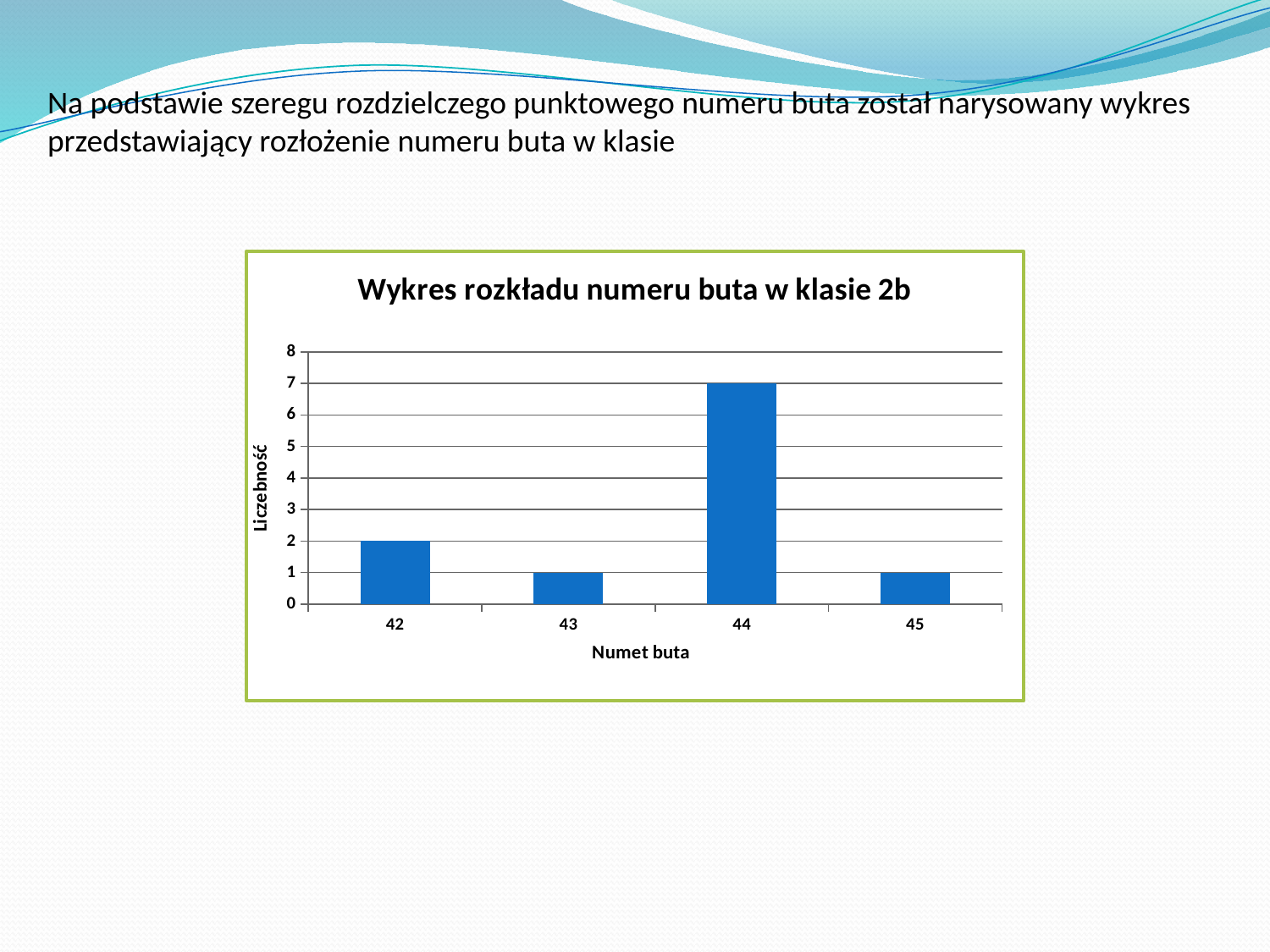
What is the total of the values for shoe sizes 42, 43, 44 and 45? 11 What is the value (Liczebność) for shoe size 42? 2 What is the difference between the values for shoe size 44 and shoe size 42? 5 What is the label of the y axis of the chart? Liczebność Is the value for shoe size 44 greater or less than 5? greater What is the value (Liczebność) for shoe size 44? 7 What is the value (Liczebność) for shoe size 43? 1 How many shoe-size categories are shown on the x axis of the chart? 4 What type of chart is shown on the slide? bar chart Which has a larger value, shoe size 42 or shoe size 45? 42 What is the title of the chart? Wykres rozkładu numeru buta w klasie 2b Which shoe size has the highest value in the chart? 44